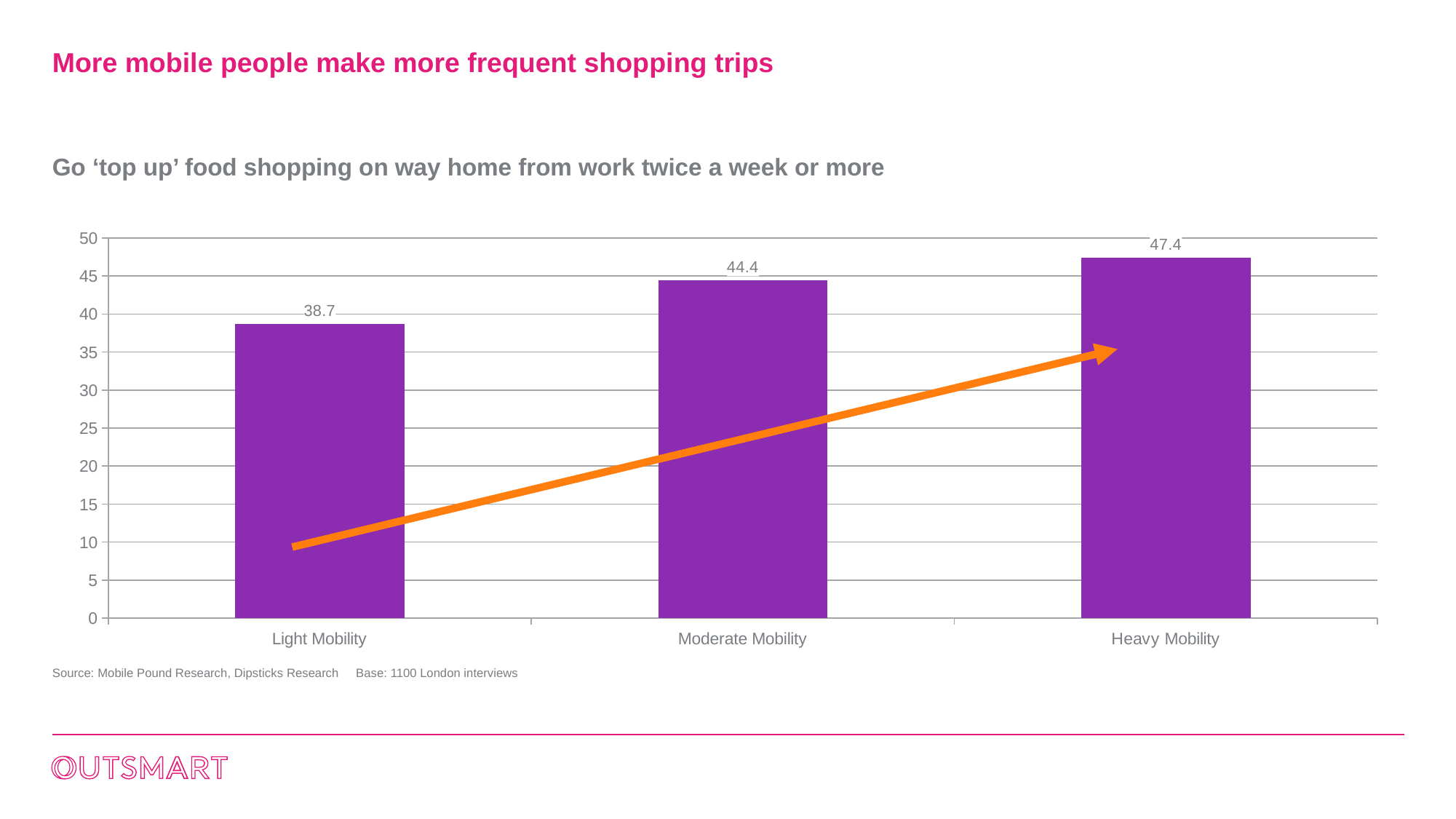
Is the value for Light Mobility greater or less than 40? less What is the value for Moderate Mobility? 44.4 What is the difference between the values for Heavy Mobility and Light Mobility? 8.7 Which is larger, the value for Moderate Mobility or the value for Light Mobility? Moderate Mobility What is the value for Heavy Mobility? 47.4 What is the value for Light Mobility? 38.7 Do the values rise or fall from Light Mobility to Heavy Mobility? rise How many categories are shown on the x axis? 3 Which category has the highest value? Heavy Mobility Which category has the lowest value? Light Mobility What kind of chart is shown on the slide? bar chart What is the difference between the values for Moderate Mobility and Light Mobility? 5.7